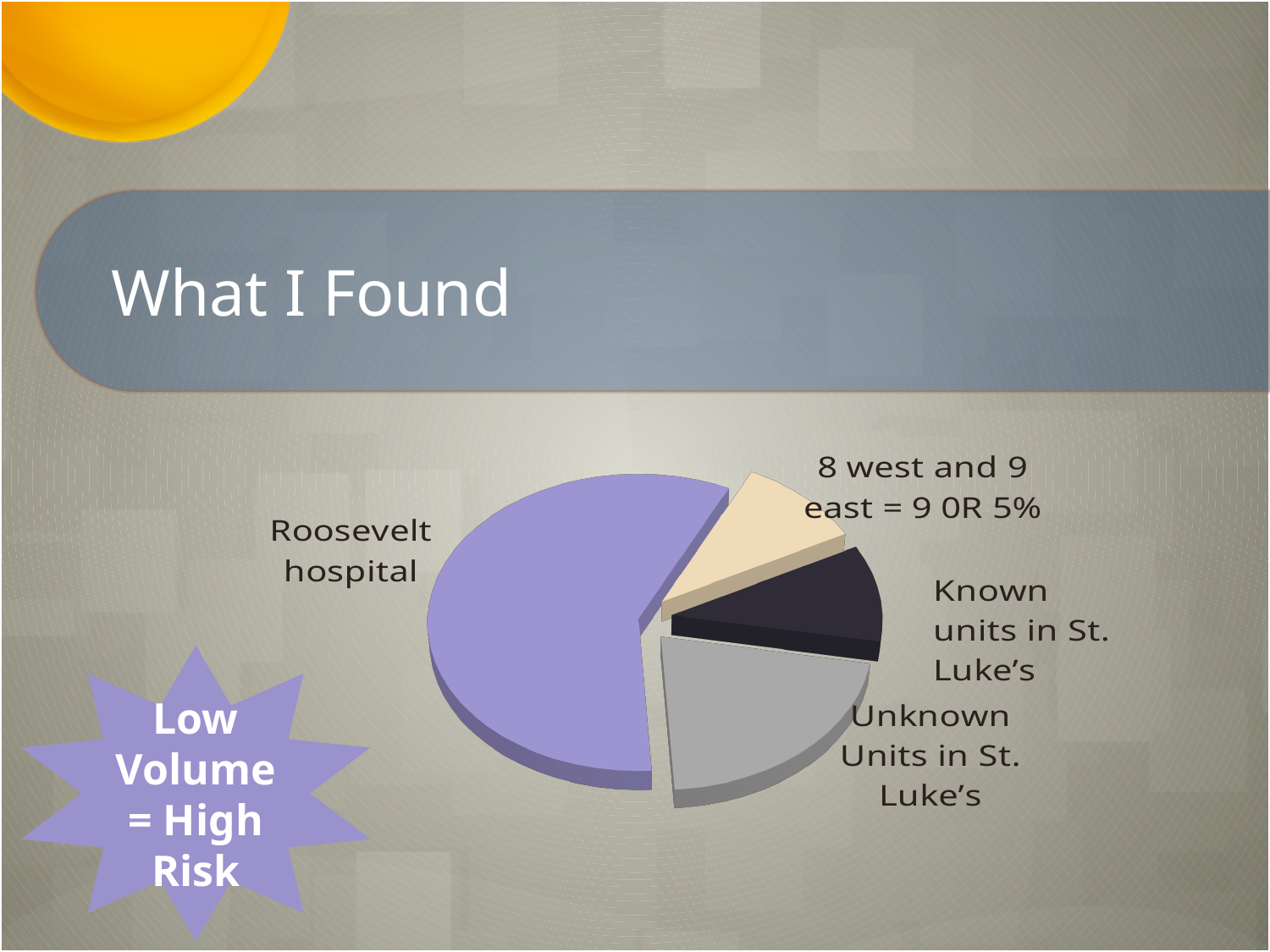
How many slices does the pie chart have? 4 Which is larger: the Unknown Units in St. Luke's slice or the Known units in St. Luke's slice? Unknown Units in St. Luke's What is the title of the slide containing the pie chart? What I Found Which slice of the pie chart is the largest? Roosevelt hospital Which is larger: the Roosevelt hospital slice or the Unknown Units in St. Luke's slice? Roosevelt hospital What share of the pie does the "8 west and 9 east" slice represent? 5% Is the share of the Known units in St. Luke's slice greater or less than 25%? less What kind of chart is shown on the slide? pie chart What colour is the Roosevelt hospital slice of the pie chart? purple Is the share of the Roosevelt hospital slice greater or less than 50%? greater